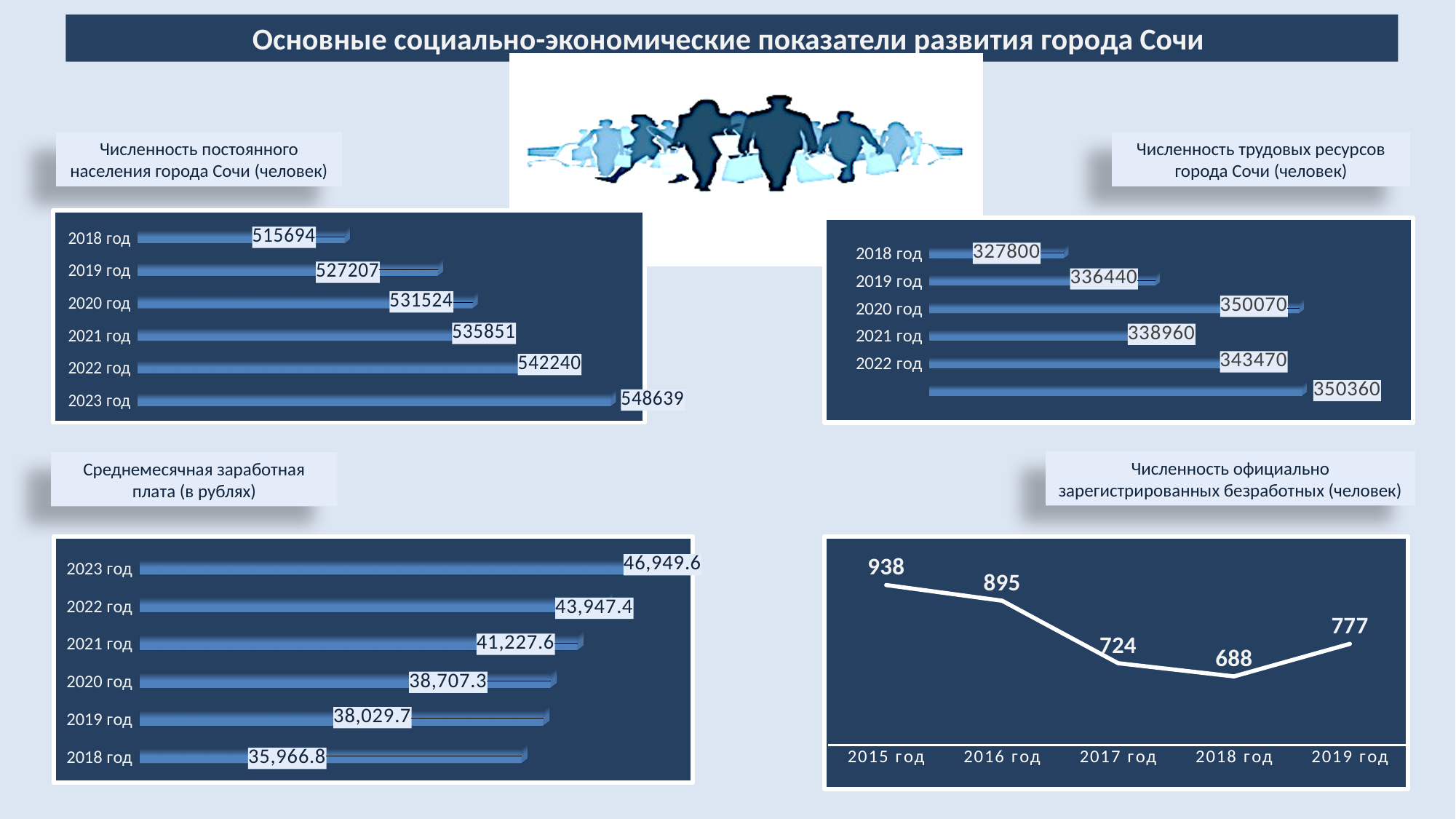
How many years are shown in the chart 'Среднемесячная заработная плата (в рублях)'? 6 In the chart 'Численность официально зарегистрированных безработных (человек)', which year has the lowest value? 2018 год In the chart 'Численность трудовых ресурсов города Сочи (человек)', what is the value for 2020 год? 350070 In the chart 'Численность постоянного населения города Сочи (человек)', what is the difference between the values for 2023 год and 2018 год? 32945 In the chart 'Среднемесячная заработная плата (в рублях)', what is the value for 2020 год? 38,707.3 In the chart 'Численность постоянного населения города Сочи (человек)', what is the value for 2021 год? 535851 In the chart 'Среднемесячная заработная плата (в рублях)', what is the value for 2018 год? 35,966.8 What kind of chart is 'Численность официально зарегистрированных безработных (человек)'? line chart In the chart 'Численность трудовых ресурсов города Сочи (человек)', which is larger: the value for 2021 год or 2022 год? 2022 год In the chart 'Численность официально зарегистрированных безработных (человек)', what is the value for 2017 год? 724 In the chart 'Численность трудовых ресурсов города Сочи (человек)', which labeled year has the lowest value? 2018 год In the chart 'Численность постоянного населения города Сочи (человек)', which year has the highest value? 2023 год